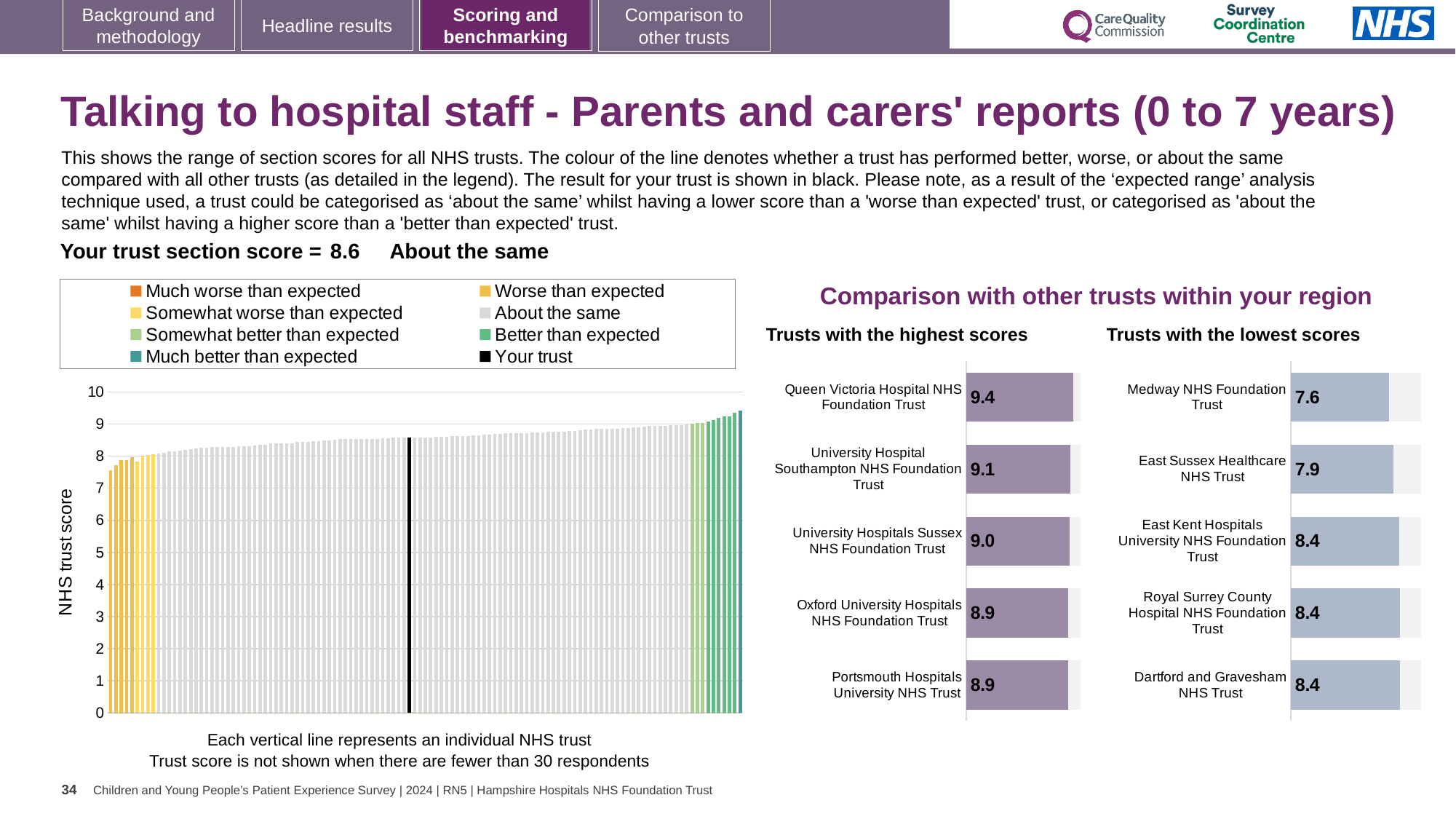
In the 'Trusts with the highest scores' chart, what is the score for University Hospitals Sussex NHS Foundation Trust? 9.0 In the NHS trust score chart on the left, do the trust scores rise or fall from left to right along the x axis? rise In the NHS trust score chart on the left, is the value for your trust (the black bar) greater or less than 8? greater In the 'Trusts with the highest scores' chart, what is the score for Queen Victoria Hospital NHS Foundation Trust? 9.4 In the 'Trusts with the highest scores' chart, which trust has the highest score? Queen Victoria Hospital NHS Foundation Trust How many trusts are shown in the 'Trusts with the highest scores' chart? 5 In the 'Trusts with the lowest scores' chart, what is the score for Medway NHS Foundation Trust? 7.6 In the 'Trusts with the lowest scores' chart, which has the larger score: Medway NHS Foundation Trust or East Sussex Healthcare NHS Trust? East Sussex Healthcare NHS Trust In the 'Trusts with the lowest scores' chart, what is the score for East Sussex Healthcare NHS Trust? 7.9 How many entries does the legend of the NHS trust score chart on the left list? 8 In the 'Trusts with the highest scores' chart, what is the difference between the scores of Queen Victoria Hospital NHS Foundation Trust and University Hospital Southampton NHS Foundation Trust? 0.3 In the 'Trusts with the lowest scores' chart, which trust has the lowest score? Medway NHS Foundation Trust